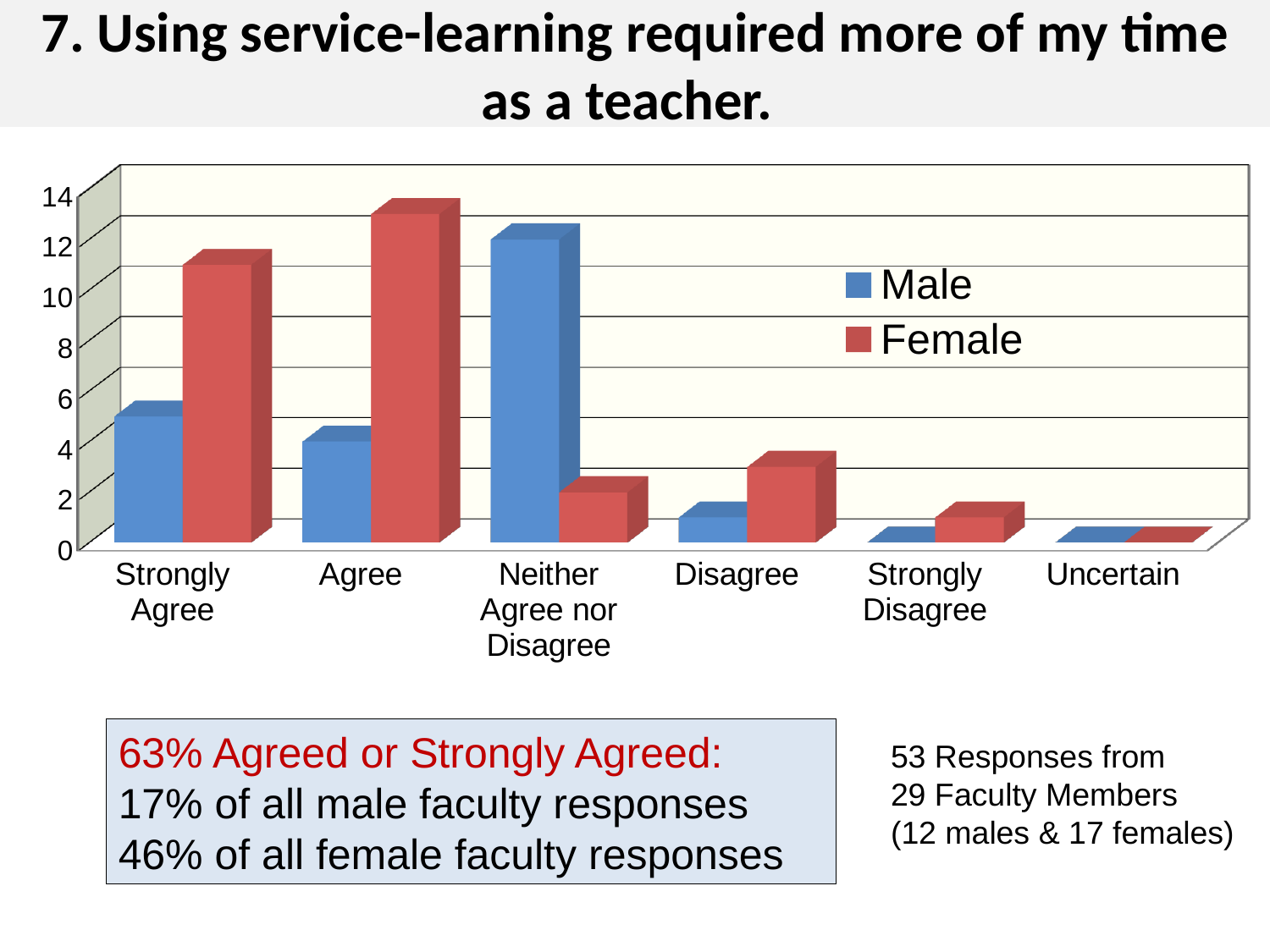
Is the Female value for Agree greater or less than 12? greater For Strongly Agree, which series has the larger value, Male or Female? Female Which category has the highest value for the Female series? Agree How many response categories are shown on the x axis? 6 Which category has the highest value for the Male series? Neither Agree nor Disagree For Neither Agree nor Disagree, which series has the larger value, Male or Female? Male Is the Male value for Neither Agree nor Disagree greater or less than 10? greater Is the Male value for Strongly Agree greater or less than 6? less What are the two entries in the chart legend? Male and Female What kind of chart is shown on the slide? bar chart How many series does the legend list? 2